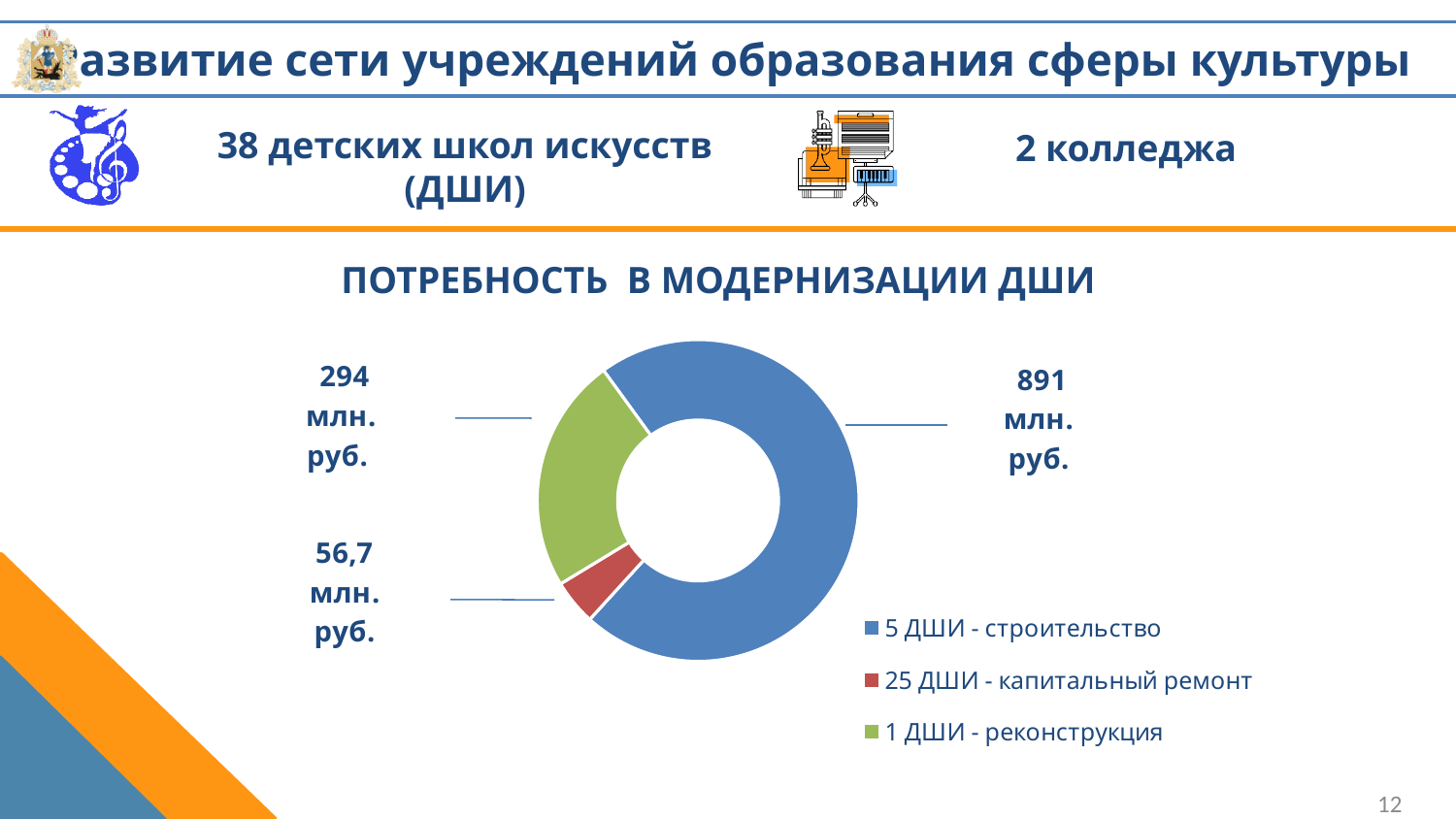
Which is larger: the value for "1 ДШИ - реконструкция" or for "25 ДШИ - капитальный ремонт"? 1 ДШИ - реконструкция What is the value for "25 ДШИ - капитальный ремонт"? 56,7 млн. руб. How many categories does the legend of the chart list? 3 Which category has the smallest value in the chart? 25 ДШИ - капитальный ремонт What type of chart is shown on the slide? Doughnut (pie) chart What is the value for "5 ДШИ - строительство"? 891 млн. руб. What is the value for "1 ДШИ - реконструкция"? 294 млн. руб. What is the total of all three values shown in the chart? 1241,7 млн. руб. What is the difference between the values for "5 ДШИ - строительство" and "1 ДШИ - реконструкция"? 597 млн. руб. Which colour represents "1 ДШИ - реконструкция" in the chart? Green Which category has the largest value in the chart? 5 ДШИ - строительство What is the title of the chart? ПОТРЕБНОСТЬ В МОДЕРНИЗАЦИИ ДШИ